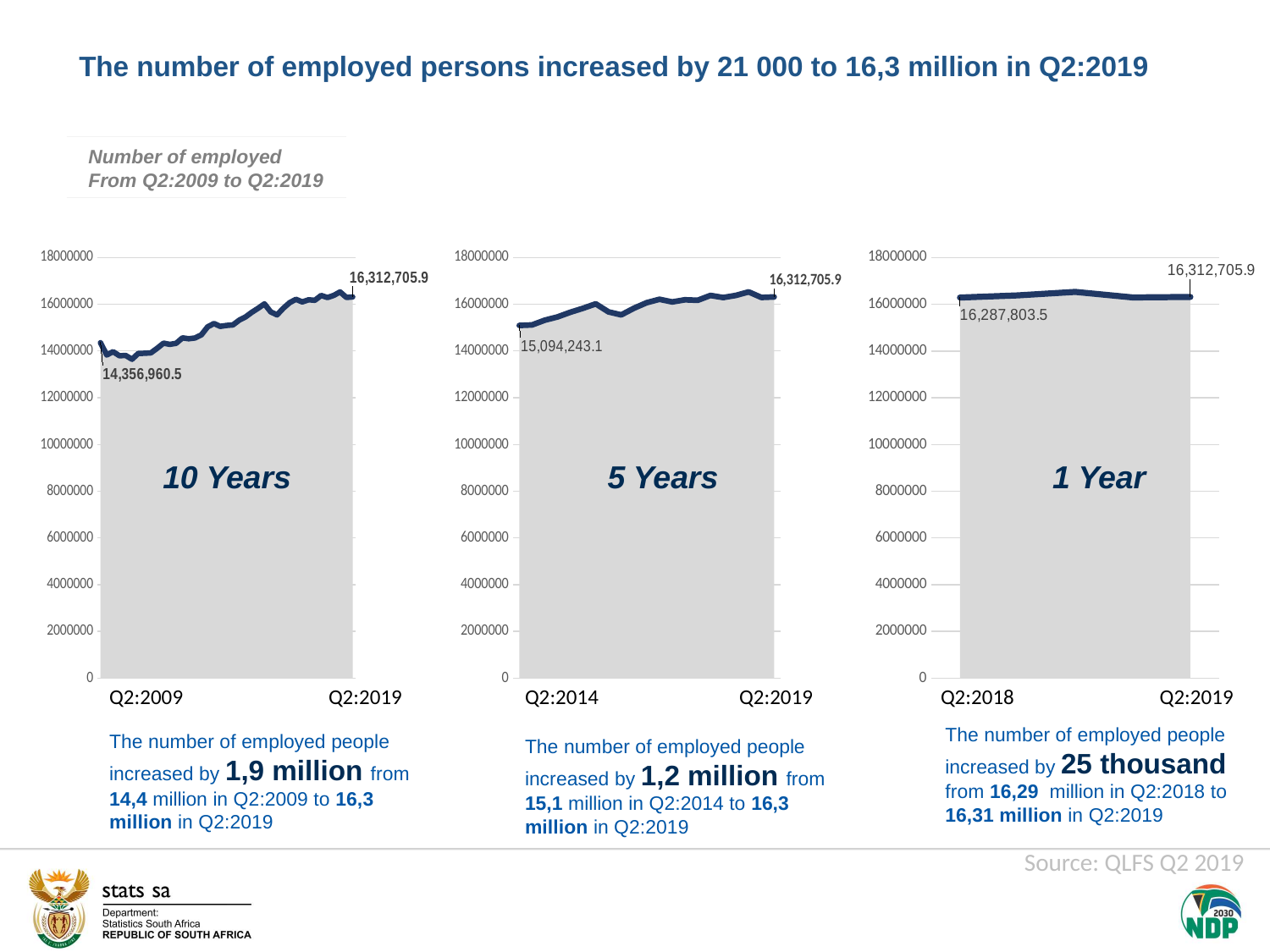
On the '1 Year' chart (right), what is the difference between the Q2:2019 and Q2:2018 values? 24,902.4 On the '10 Years' chart (left), do the values generally rise or fall from Q2:2009 to Q2:2019? rise How many charts are shown on the slide? 3 On the '10 Years' chart (left), what is the number of employed persons in Q2:2009? 14,356,960.5 On the '10 Years' chart (left), what is the difference between the Q2:2019 and Q2:2009 values? 1,955,745.4 On the '5 Years' chart (middle), what is the number of employed persons in Q2:2014? 15,094,243.1 On the '5 Years' chart (middle), is the value for Q2:2014 greater or less than 16000000? less On the '5 Years' chart (middle), what is the difference between the Q2:2019 and Q2:2014 values? 1,218,462.8 On the '1 Year' chart (right), what is the number of employed persons in Q2:2018? 16,287,803.5 On the '10 Years' chart (left), which is larger, the value for Q2:2009 or the value for Q2:2019? Q2:2019 On the '10 Years' chart (left), what is the number of employed persons in Q2:2019? 16,312,705.9 What kind of chart is the '5 Years' chart (middle)? line chart with a shaded area beneath (combination area and line chart)